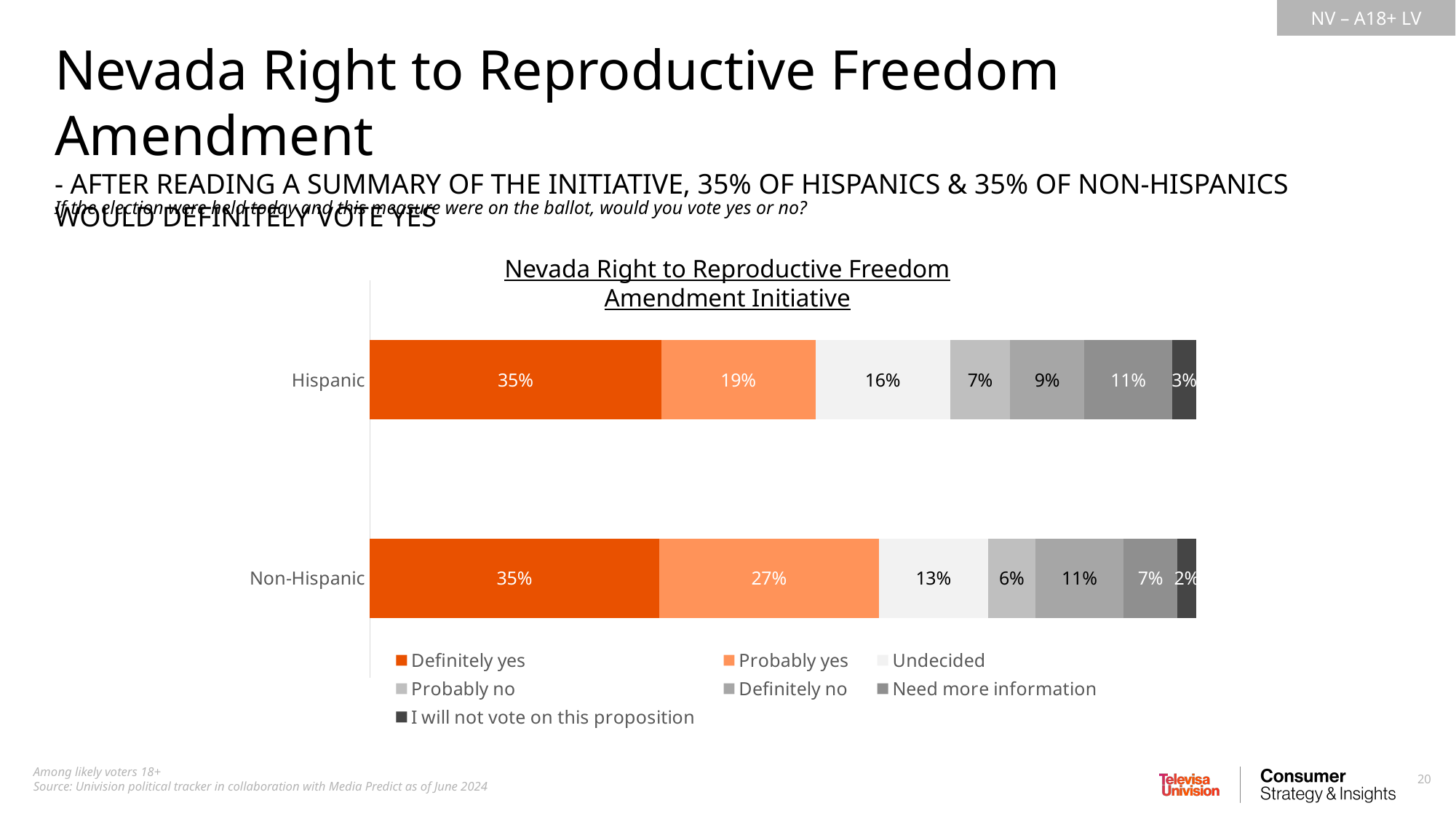
Which group has the larger "Definitely no" share, Hispanic or Non-Hispanic? Non-Hispanic Which response category has the smallest share in the Non-Hispanic bar? I will not vote on this proposition What percentage of Hispanic likely voters said "Definitely yes"? 35% What is the "Undecided" value for the Hispanic bar? 16% How many groups (bars) are shown in the chart? 2 What is the title of the chart? Nevada Right to Reproductive Freedom Amendment Initiative What is the difference between the "Probably yes" values for Non-Hispanic and Hispanic respondents? 8 percentage points What percentage of Non-Hispanic likely voters said "Probably yes"? 27% How many series does the legend list? 7 What is the "Need more information" value for the Non-Hispanic bar? 7% Which response category has the largest share in the Hispanic bar? Definitely yes What kind of chart is shown on the slide? Stacked bar chart